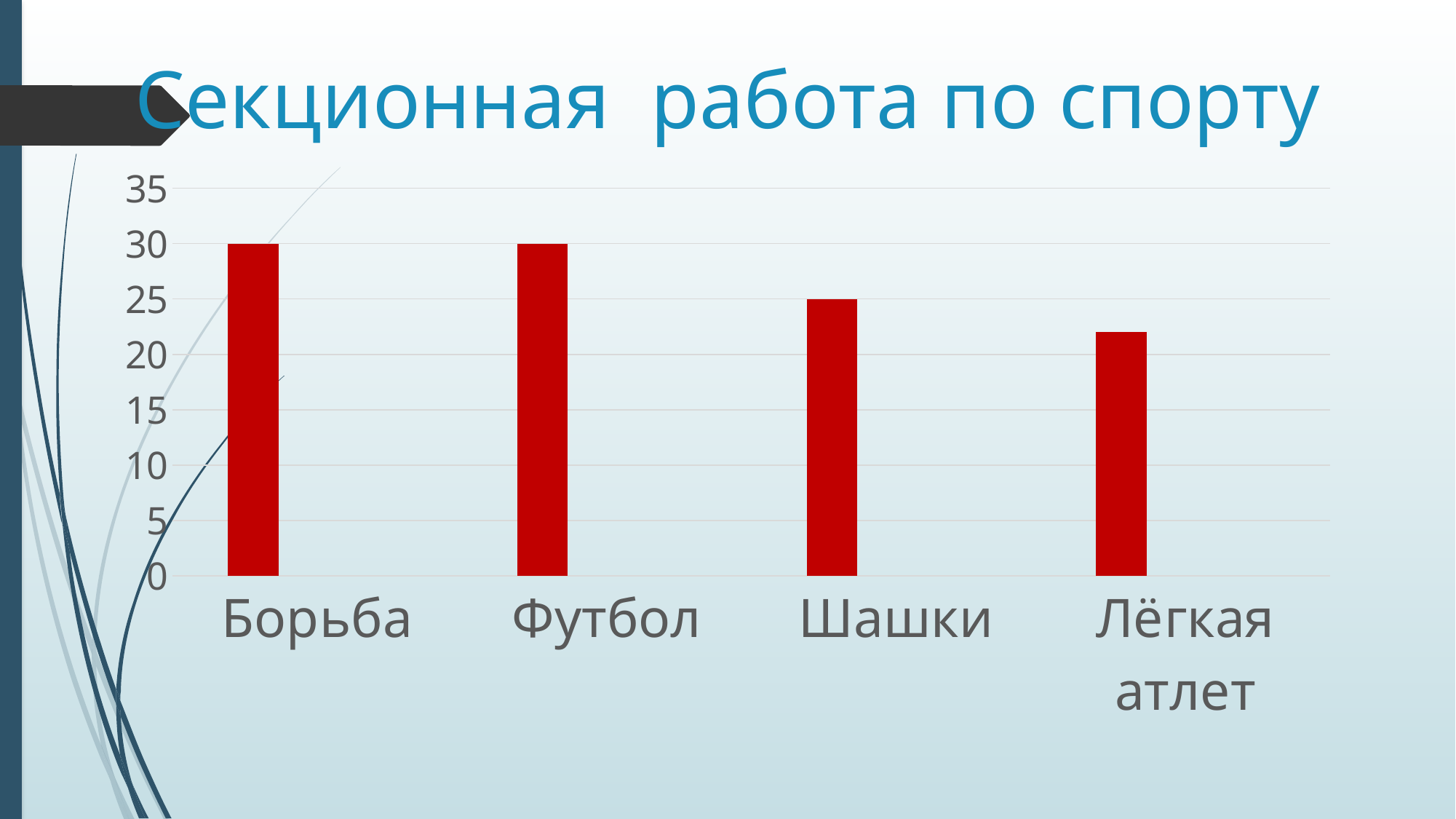
How many categories are shown on the chart? 4 Do the values rise or fall from left to right along the x axis? fall What is the value for Футбол? 30 Which is larger, the value for Шашки or the value for Лёгкая атлет? Шашки What is the difference between the values for Борьба and Шашки? 5 Is the value for Лёгкая атлет greater or less than 20? greater What is the title of the slide? Секционная работа по спорту What is the value for Борьба? 30 What kind of chart is shown on the slide? bar chart Is the value for Лёгкая атлет greater or less than 25? less What is the value for Шашки? 25 Which category has the lowest value? Лёгкая атлет